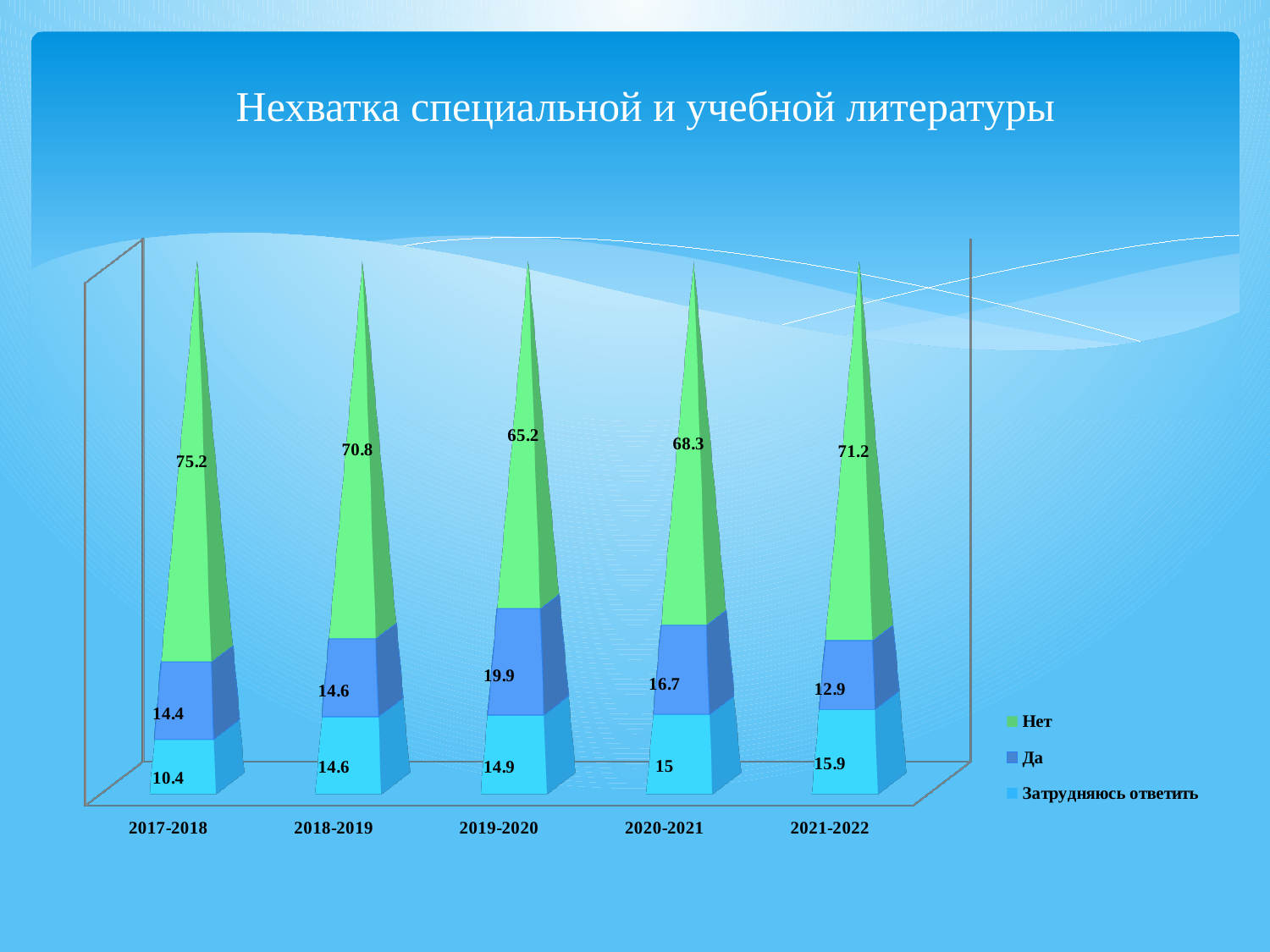
What is the total of the stacked bar for 2018-2019? 100 What is the value for "Затрудняюсь ответить" in 2021-2022? 15.9 In which year is the value for "Затрудняюсь ответить" the lowest? 2017-2018 How many series does the legend list? 3 How many year categories are shown on the x axis? 5 What is the difference between the "Нет" values for 2017-2018 and 2019-2020? 10 Which is larger: the "Да" value in 2020-2021 or in 2021-2022? 2020-2021 What kind of chart is shown on the slide? Stacked bar chart What is the value for "Да" in 2019-2020? 19.9 In which year is the value for "Да" the highest? 2019-2020 In which year is the value for "Нет" the lowest? 2019-2020 What is the value for "Нет" in 2017-2018? 75.2